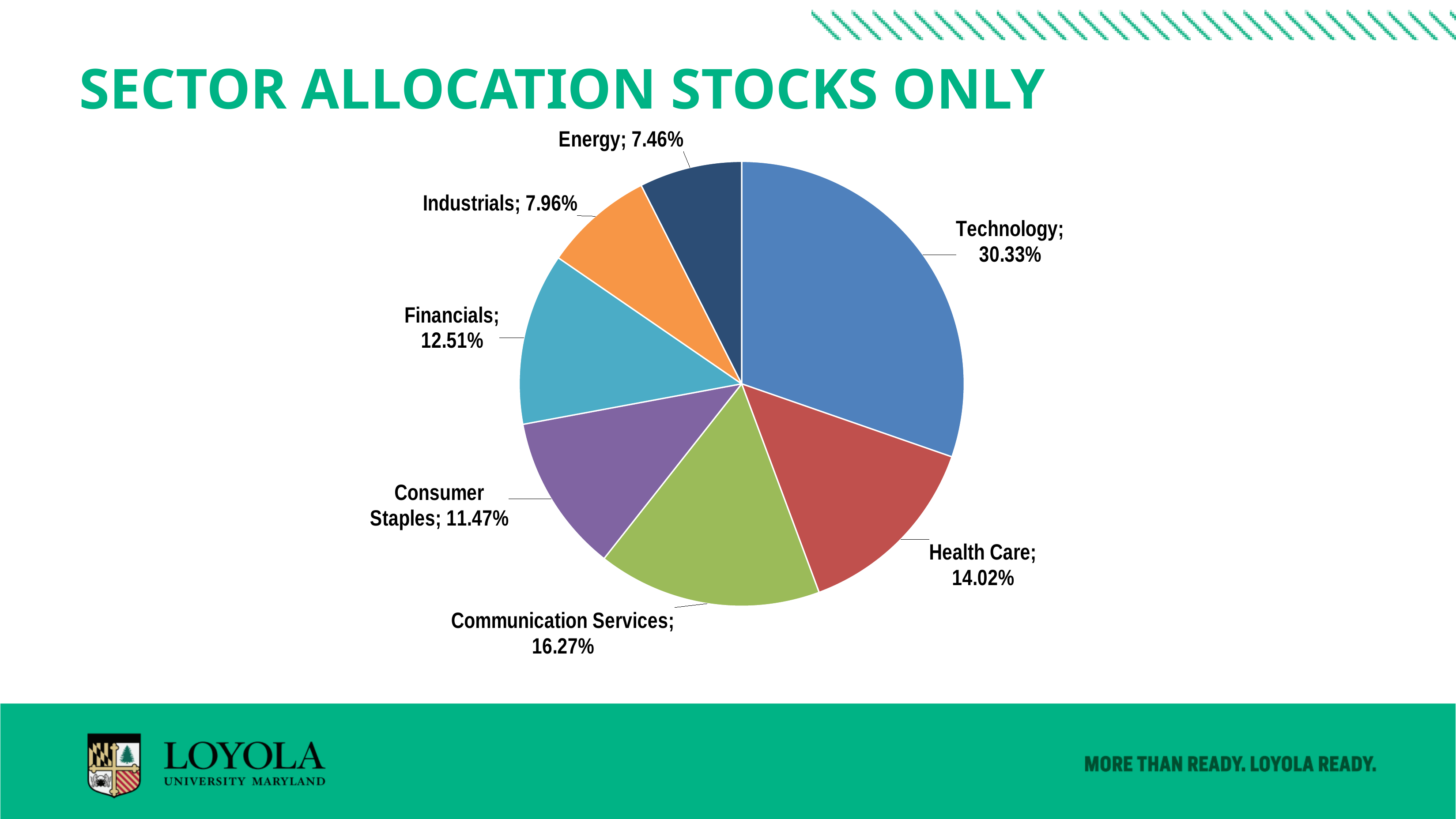
What is the value for Financials? 12.51% What is the title of the slide containing the chart? SECTOR ALLOCATION STOCKS ONLY How many sectors are shown in the pie chart? 7 Which sector has the smallest share of the pie? Energy What share of the pie does Technology hold? 30.33% Which is larger, the share for Financials or the share for Consumer Staples? Financials What is the value for Consumer Staples? 11.47% What kind of chart is shown on the slide? Pie chart What is the value for Health Care? 14.02% What is the value for Communication Services? 16.27% Which sector has the largest share of the pie? Technology What is the difference between the Technology and Health Care shares? 16.31%